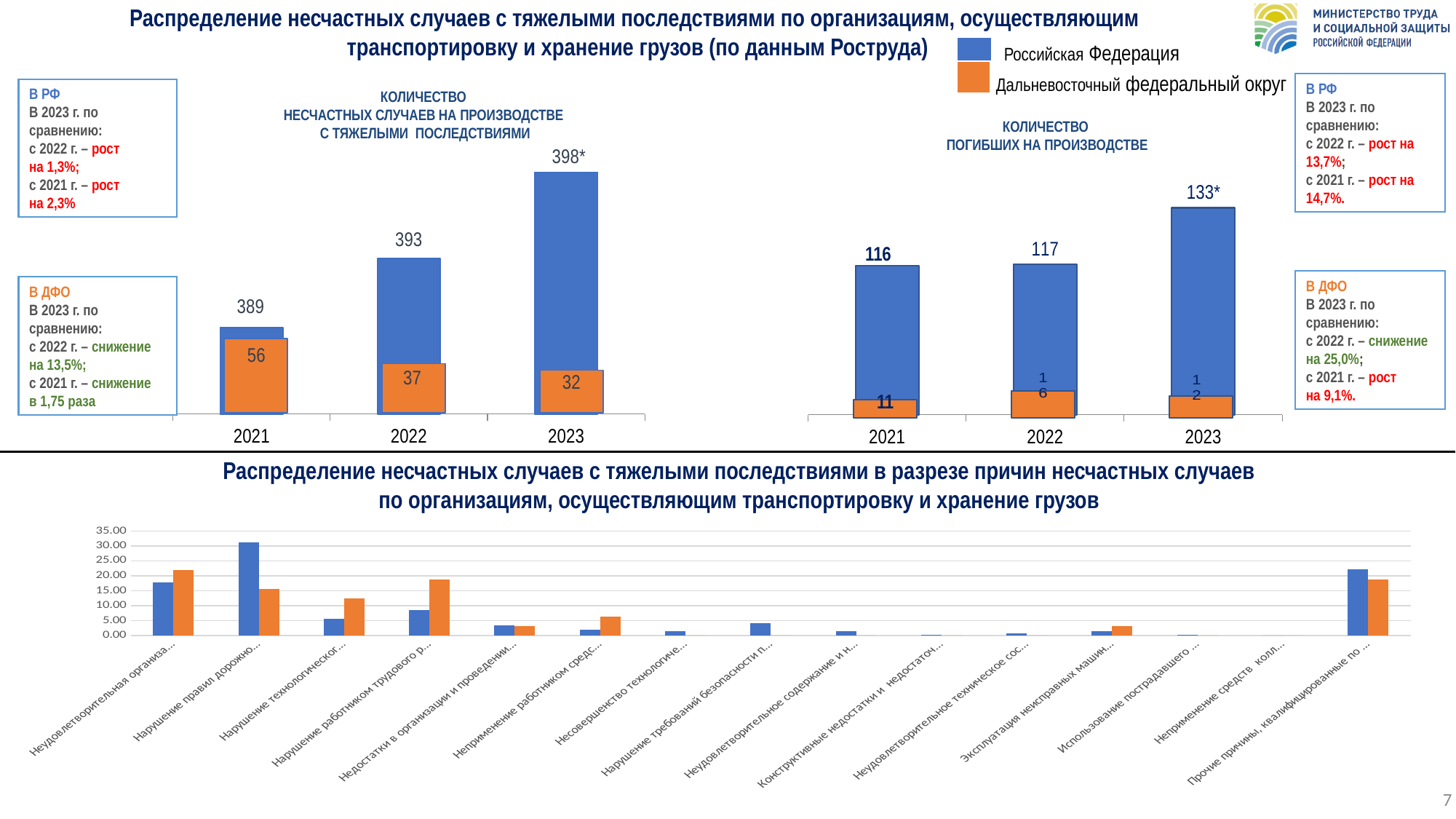
In the chart 'Количество погибших на производстве', what is the difference between the Российская Федерация values for 2023 and 2022? 16 What kind of chart is the bottom chart on the slide? bar chart In the chart 'Количество несчастных случаев на производстве с тяжелыми последствиями', do the Российская Федерация values rise or fall from 2021 to 2023? rise In the bottom chart 'Распределение несчастных случаев с тяжелыми последствиями в разрезе причин', is the blue bar for the second category from the left greater or less than 25.00? greater In the chart 'Количество несчастных случаев на производстве с тяжелыми последствиями', which year has the lowest value for Дальневосточный федеральный округ? 2023 In the chart 'Количество погибших на производстве', what is the value for Российская Федерация in 2023? 133* In the chart 'Количество несчастных случаев на производстве с тяжелыми последствиями', what is the value for Дальневосточный федеральный округ in 2021? 56 In the chart 'Количество несчастных случаев на производстве с тяжелыми последствиями', what is the value for Российская Федерация in 2022? 393 In the chart 'Количество несчастных случаев на производстве с тяжелыми последствиями', what is the difference between the Дальневосточный федеральный округ values for 2021 and 2023? 24 How many series does the legend at the top of the slide list? 2 In the chart 'Количество погибших на производстве', what is the value for Дальневосточный федеральный округ in 2022? 16 In the chart 'Количество погибших на производстве', which year has the highest value for Российская Федерация? 2023